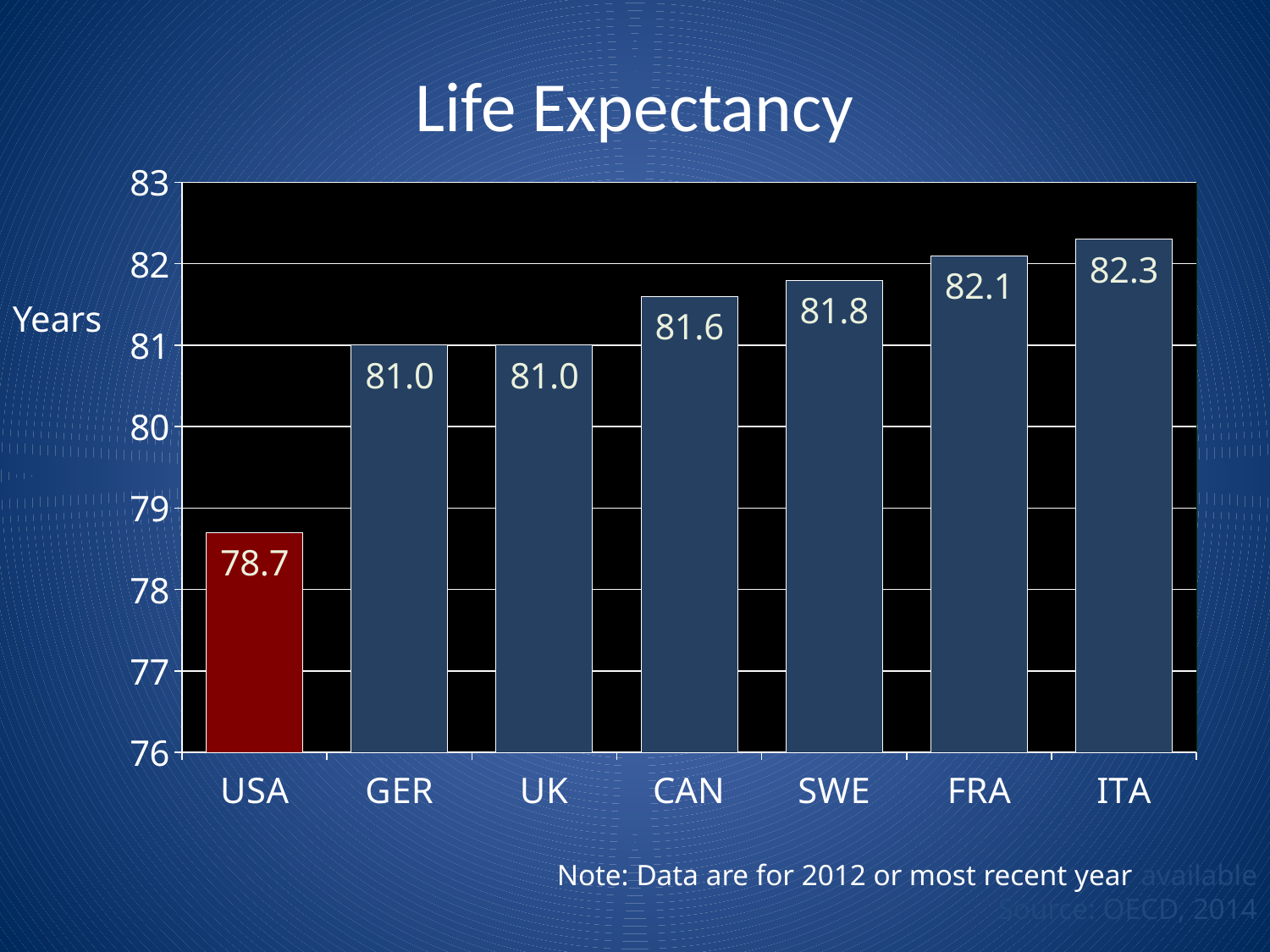
How many countries are shown on the chart? 7 What is the difference in life expectancy between Italy (ITA) and the USA? 3.6 What type of chart is shown on the slide? Bar chart Which country has the lowest life expectancy on the chart? USA What is the title of the chart? Life Expectancy What is the difference in life expectancy between Sweden (SWE) and Germany (GER)? 0.8 Which has a higher life expectancy, Sweden (SWE) or Canada (CAN)? SWE Which country has the highest life expectancy on the chart? ITA Is the life expectancy value for the USA greater or less than 79? less What is the life expectancy value shown for Canada (CAN)? 81.6 What is the life expectancy value shown for France (FRA)? 82.1 What is the life expectancy value shown for the USA? 78.7